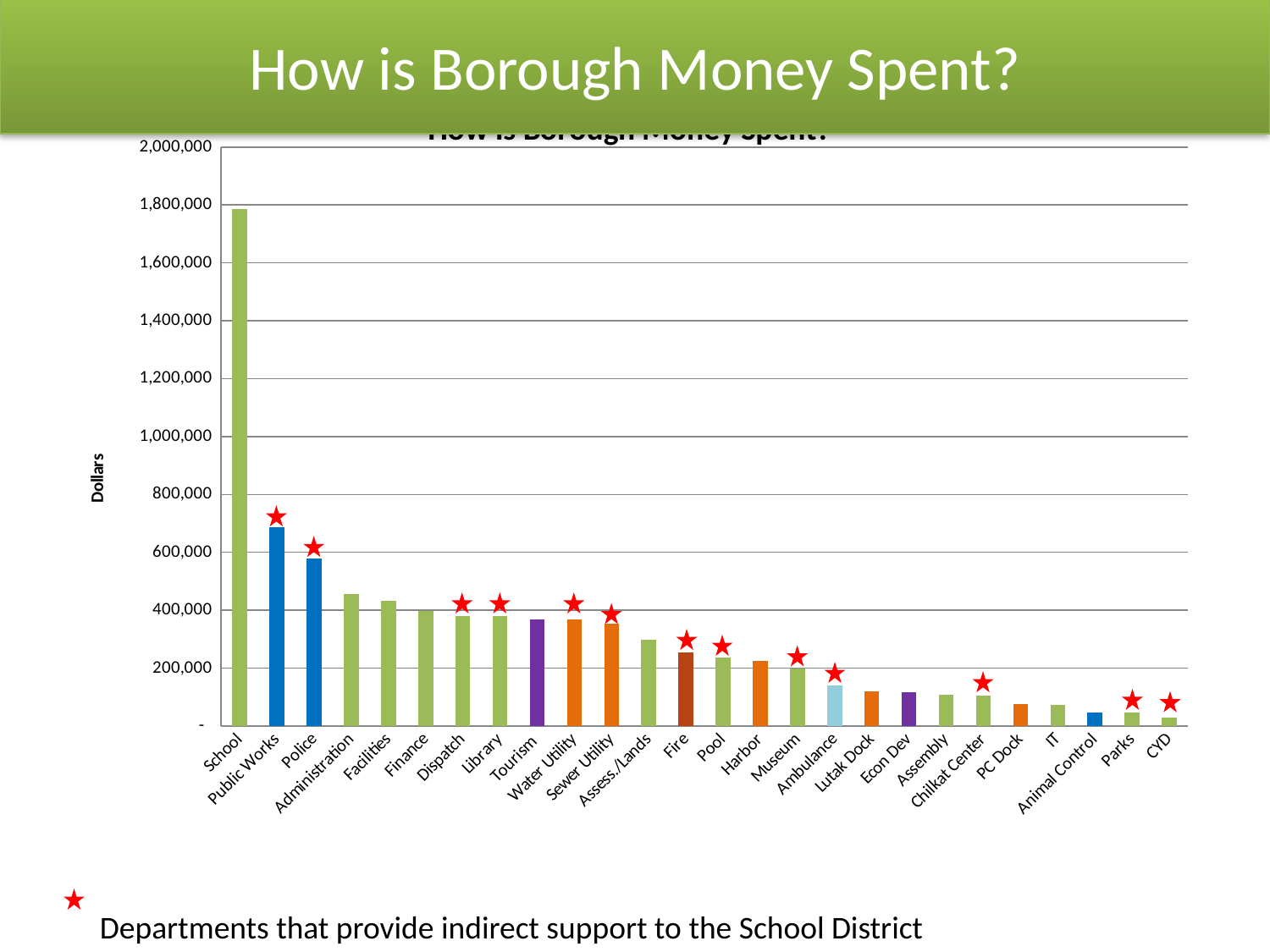
Which department has the highest spending in the chart? School Do the bar values generally rise or fall from left to right along the x axis? Fall Is the value for School greater or less than 1,600,000? greater Is the value for Administration greater or less than 400,000? greater Which has a larger value, Public Works or Police? Public Works How many departments are shown along the x axis of the chart? 26 Is the value for Public Works greater or less than 600,000? greater What kind of chart is shown on the slide? Bar chart What is the label on the vertical axis of the chart? Dollars Which department has the lowest spending in the chart? CYD